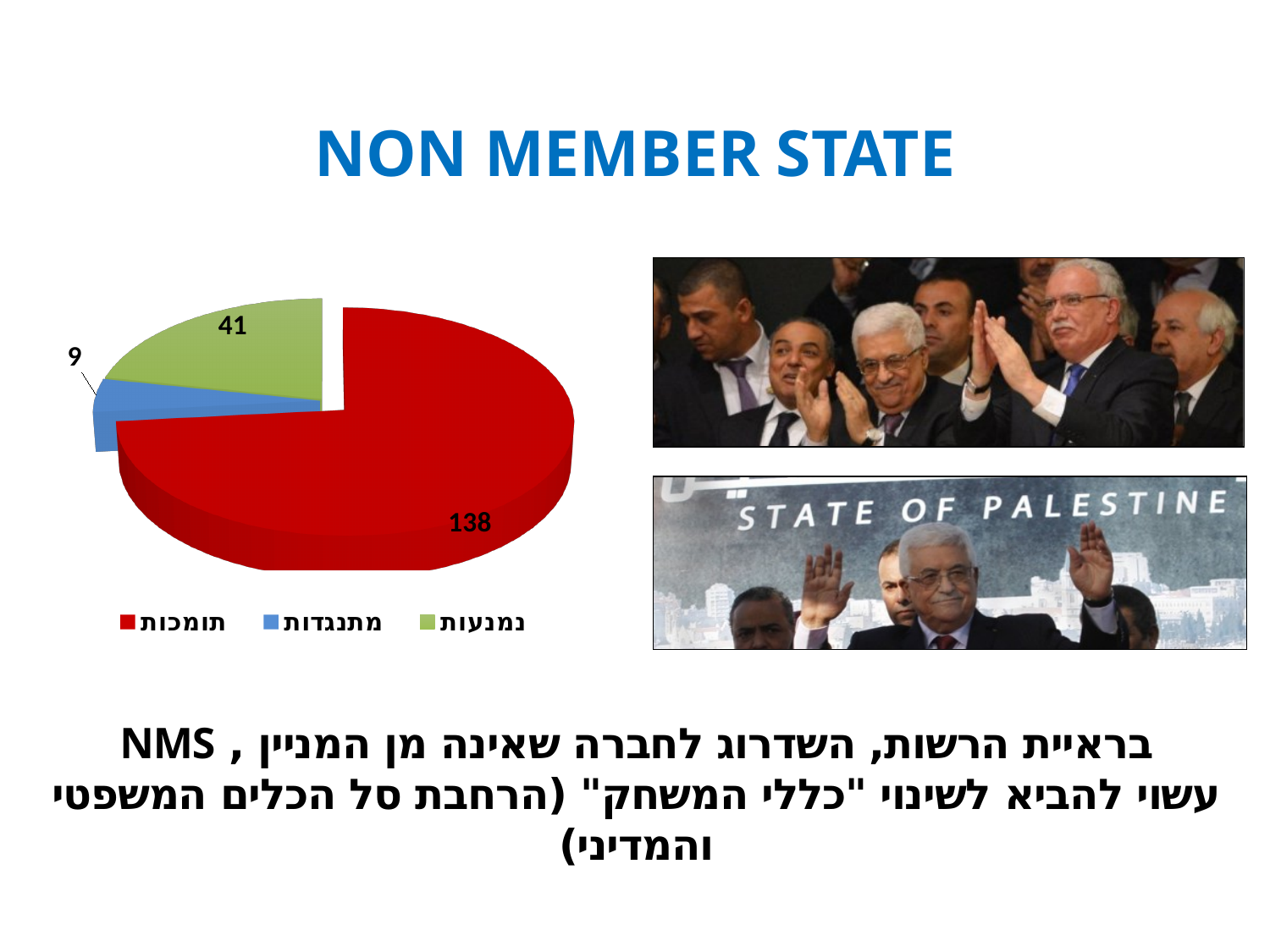
Which category has the largest slice in the pie chart? תומכות What kind of chart is shown on the slide? Pie chart What value is shown for the תומכות slice of the pie chart? 138 How many entries does the chart legend list? 3 Which category has the smallest slice in the pie chart? מתנגדות What is the total of all three values in the pie chart? 188 What is the difference between the תומכות value and the נמנעות value? 97 What value is shown for the מתנגדות slice of the pie chart? 9 What value is shown for the נמנעות slice of the pie chart? 41 What colour is the תומכות slice in the pie chart? Red Which is larger, the נמנעות slice or the מתנגדות slice? נמנעות How many slices does the pie chart have? 3